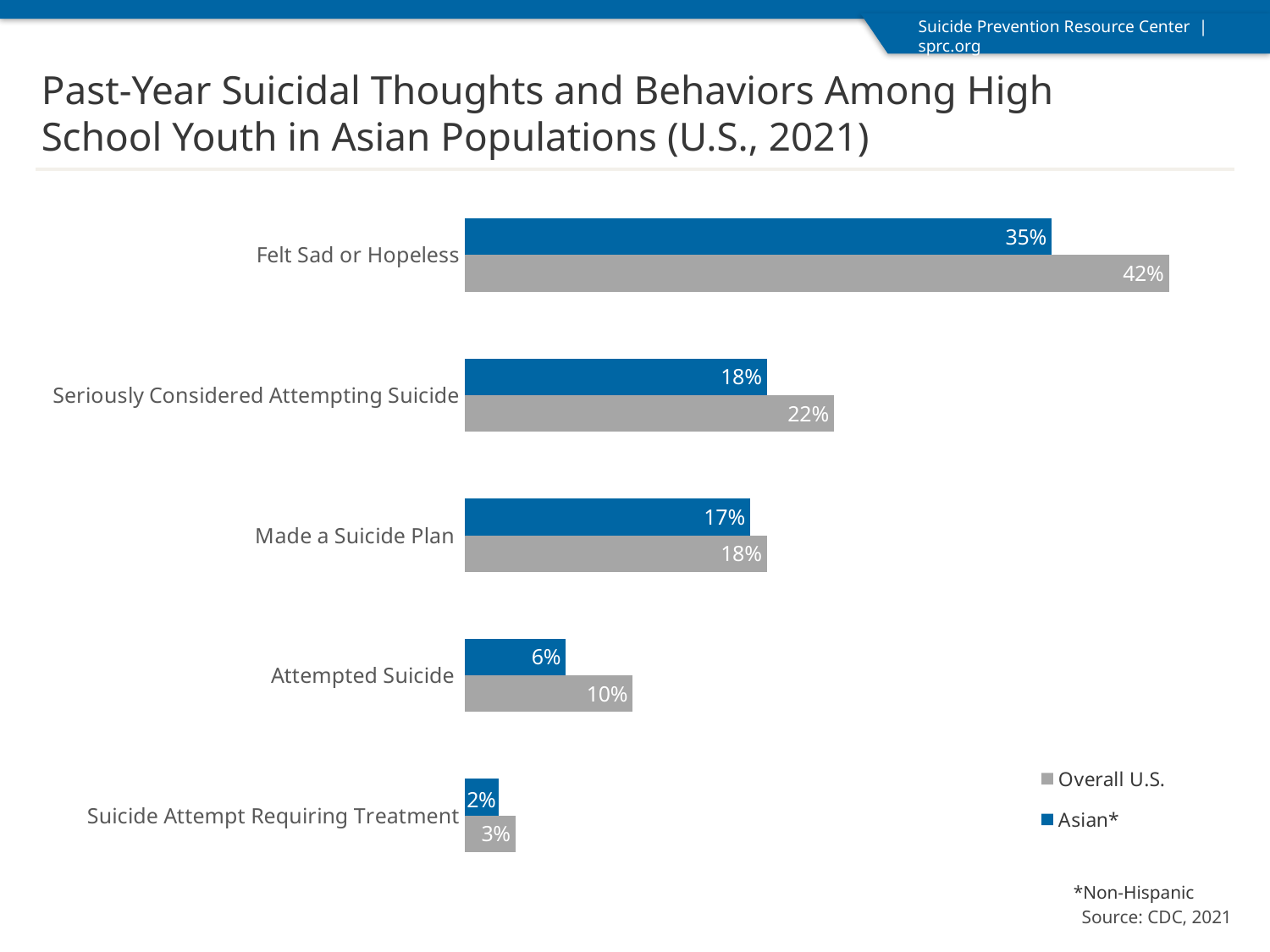
How many categories are shown in the chart? 5 Which category has the lowest Asian* value? Suicide Attempt Requiring Treatment What kind of chart is shown on the slide? Bar chart What is the difference between the Overall U.S. and Asian* values for Felt Sad or Hopeless? 7% What is the Asian* value for Suicide Attempt Requiring Treatment? 2% Which category has the highest Overall U.S. value? Felt Sad or Hopeless What is the Asian* value for Felt Sad or Hopeless? 35% Which is larger for Made a Suicide Plan, the Overall U.S. value or the Asian* value? Overall U.S. How many series does the legend list? 2 What is the difference between the Overall U.S. and Asian* values for Attempted Suicide? 4% What is the Overall U.S. value for Attempted Suicide? 10% What is the Overall U.S. value for Seriously Considered Attempting Suicide? 22%